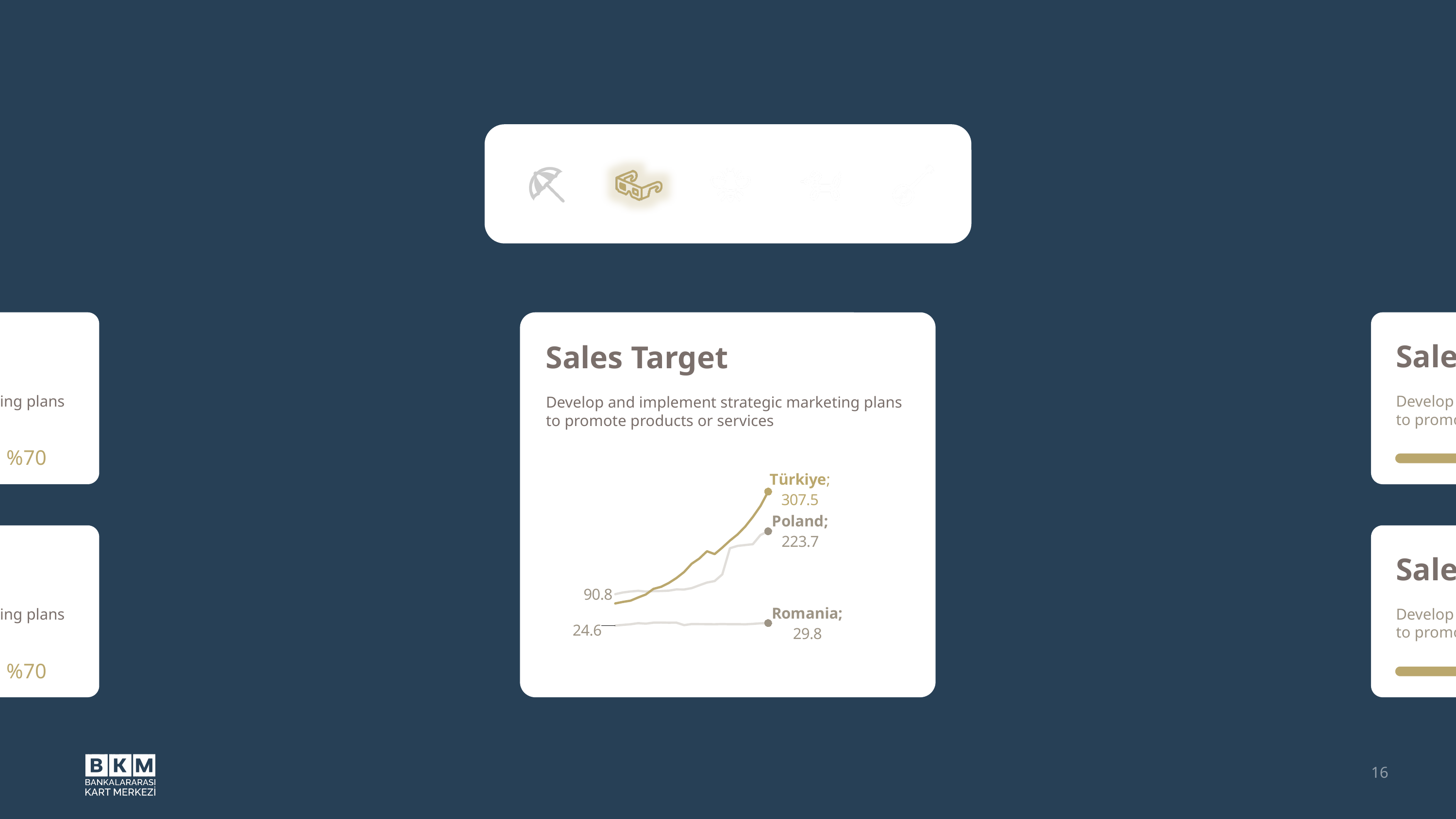
What type of chart is shown on the Sales Target card? line chart What is the difference between the final values of Türkiye and Poland in the Sales Target chart? 83.8 What is the final labelled value for Romania in the Sales Target chart? 29.8 Which series ends with the lowest value in the Sales Target chart? Romania Which series ends with the highest value in the Sales Target chart? Türkiye What is the final labelled value for Poland in the Sales Target chart? 223.7 Which ends higher in the Sales Target chart, Poland or Romania? Poland Does the Türkiye line rise or fall from left to right in the Sales Target chart? rise What is the starting labelled value of the Romania line in the Sales Target chart? 24.6 By how much does the Romania line increase from its first labelled value to its last in the Sales Target chart? 5.2 What is the final labelled value for Türkiye in the Sales Target chart? 307.5 How many series (lines) are plotted in the Sales Target chart? 3